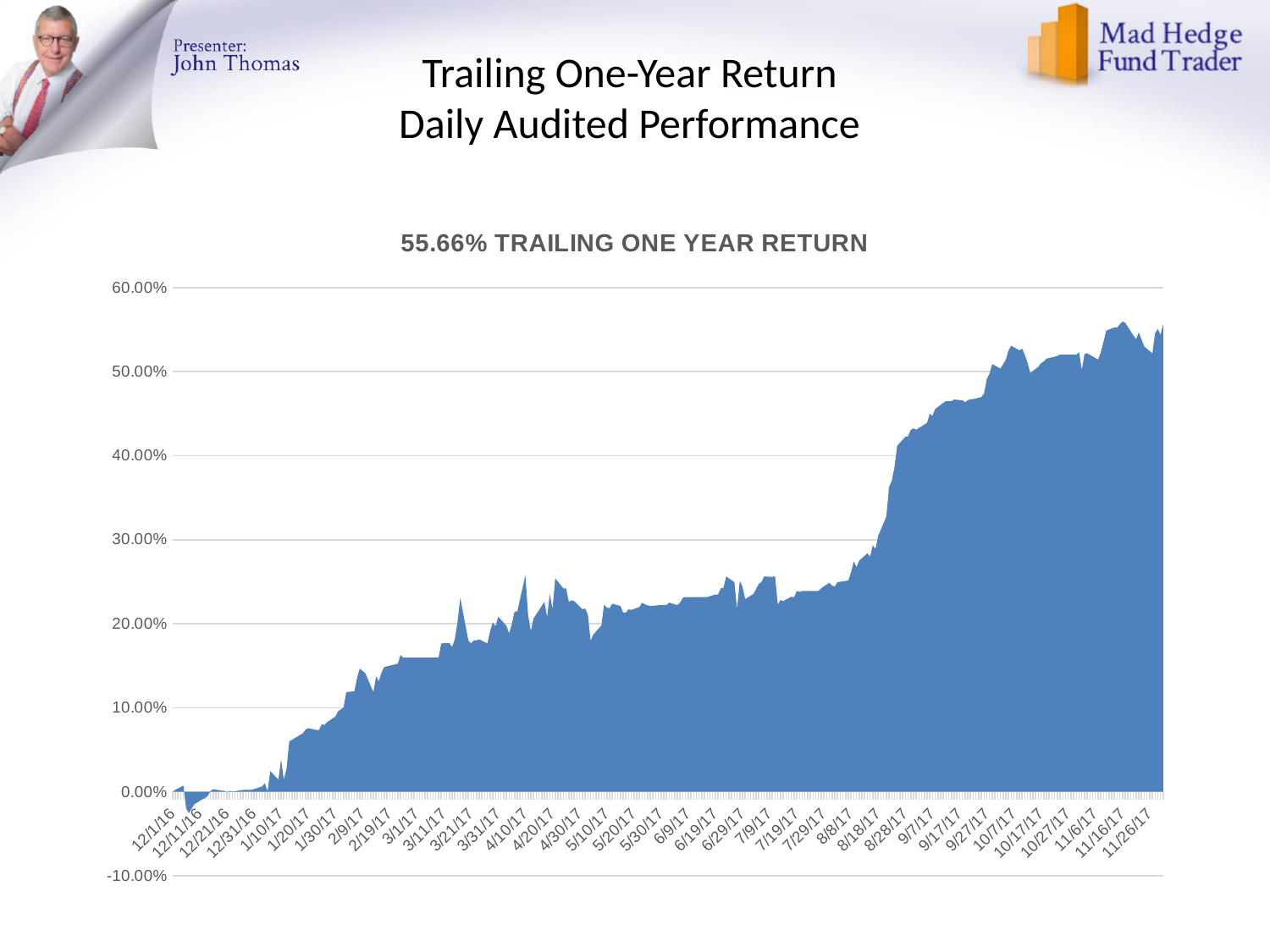
What is the highest value shown on the vertical axis? 60.00% What trailing one-year return figure is stated in the chart title? 55.66% Is the value for 1/20/17 greater or less than 10.00%? less Is the value for 12/21/16 greater or less than 10.00%? less Is the value for 6/19/17 greater or less than 30.00%? less What is the title of the chart? 55.66% TRAILING ONE YEAR RETURN What kind of chart is shown on the slide? area chart Which date is the last label on the horizontal axis? 11/26/17 Does the trailing one-year return generally rise or fall from 12/1/16 to 11/26/17? rise